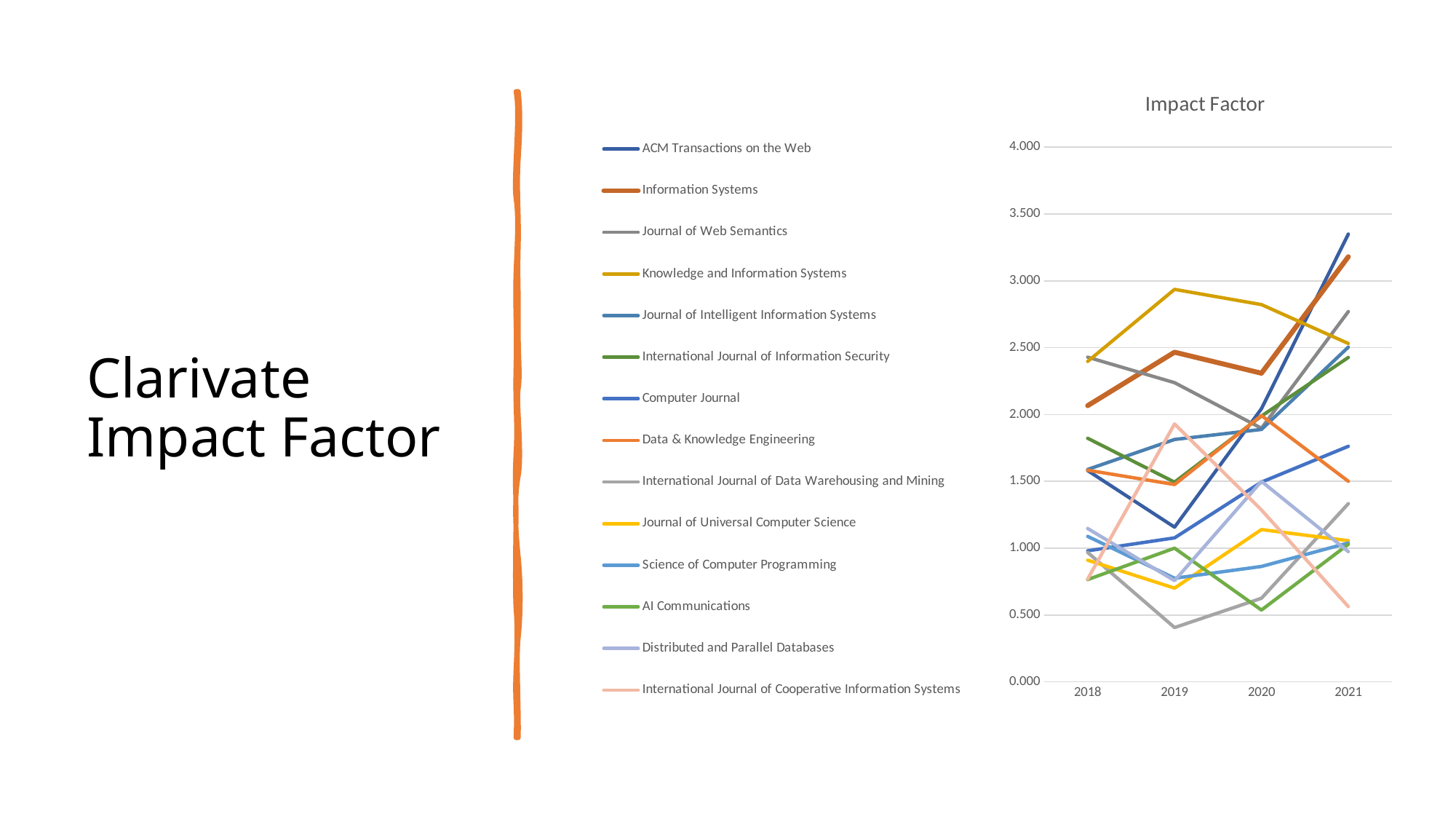
Does the impact factor of Journal of Intelligent Information Systems rise or fall from 2018 to 2021? rises Is the 2019 value for International Journal of Data Warehousing and Mining greater or less than 0.500? less How many years are shown on the x axis of the Impact Factor chart? 4 In 2021, which has the larger impact factor: Information Systems or Journal of Web Semantics? Information Systems Which journal has the lowest impact factor in 2019? International Journal of Data Warehousing and Mining Is the 2021 value for ACM Transactions on the Web greater or less than 3.000? greater Which journal has the highest impact factor in 2019? Knowledge and Information Systems How many series does the legend of the Impact Factor chart list? 14 What kind of chart is shown on the slide? line chart What is the title of the chart? Impact Factor Which journal has the highest impact factor in 2021? ACM Transactions on the Web Which journal has the lowest impact factor in 2021? International Journal of Cooperative Information Systems